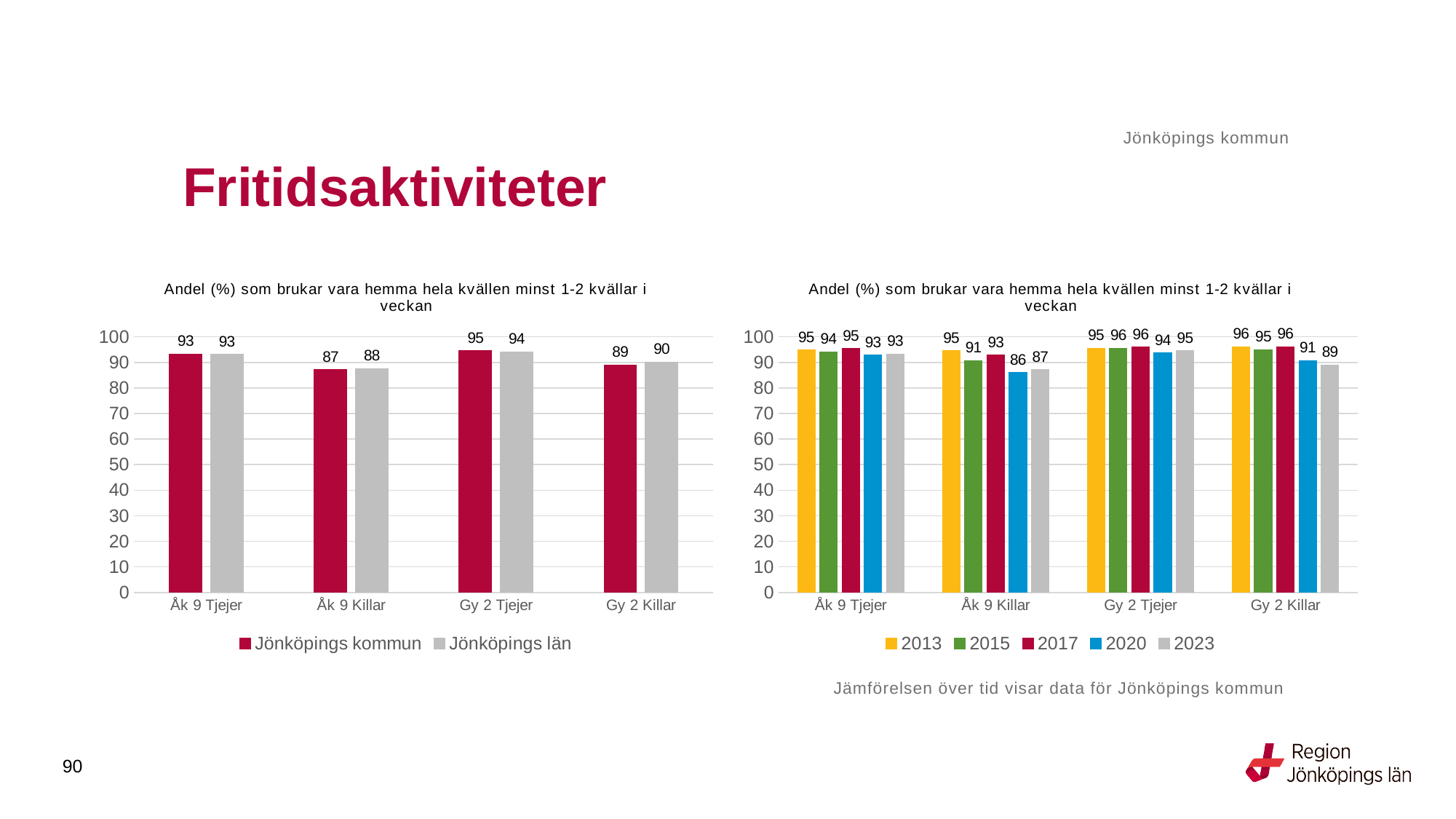
What kind of chart is the left chart? Bar chart In the left chart, what is the value for Jönköpings kommun for Åk 9 Killar? 87 In the left chart, how many series does the legend list? 2 In the left chart, what is the difference between Jönköpings kommun and Jönköpings län for Gy 2 Tjejer? 1 In the left chart, which category has the lowest value for Jönköpings kommun? Åk 9 Killar In the right chart, which year has the lowest value for Gy 2 Killar? 2023 In the left chart, what is the value for Jönköpings län for Gy 2 Killar? 90 In the right chart, how many series does the legend list? 5 In the right chart, what is the difference between the 2013 and 2023 values for Åk 9 Killar? 8 In the right chart, what is the value for 2020 for Åk 9 Killar? 86 In the right chart, what is the value for 2013 for Gy 2 Killar? 96 In the right chart, how many categories are shown on the x axis? 4